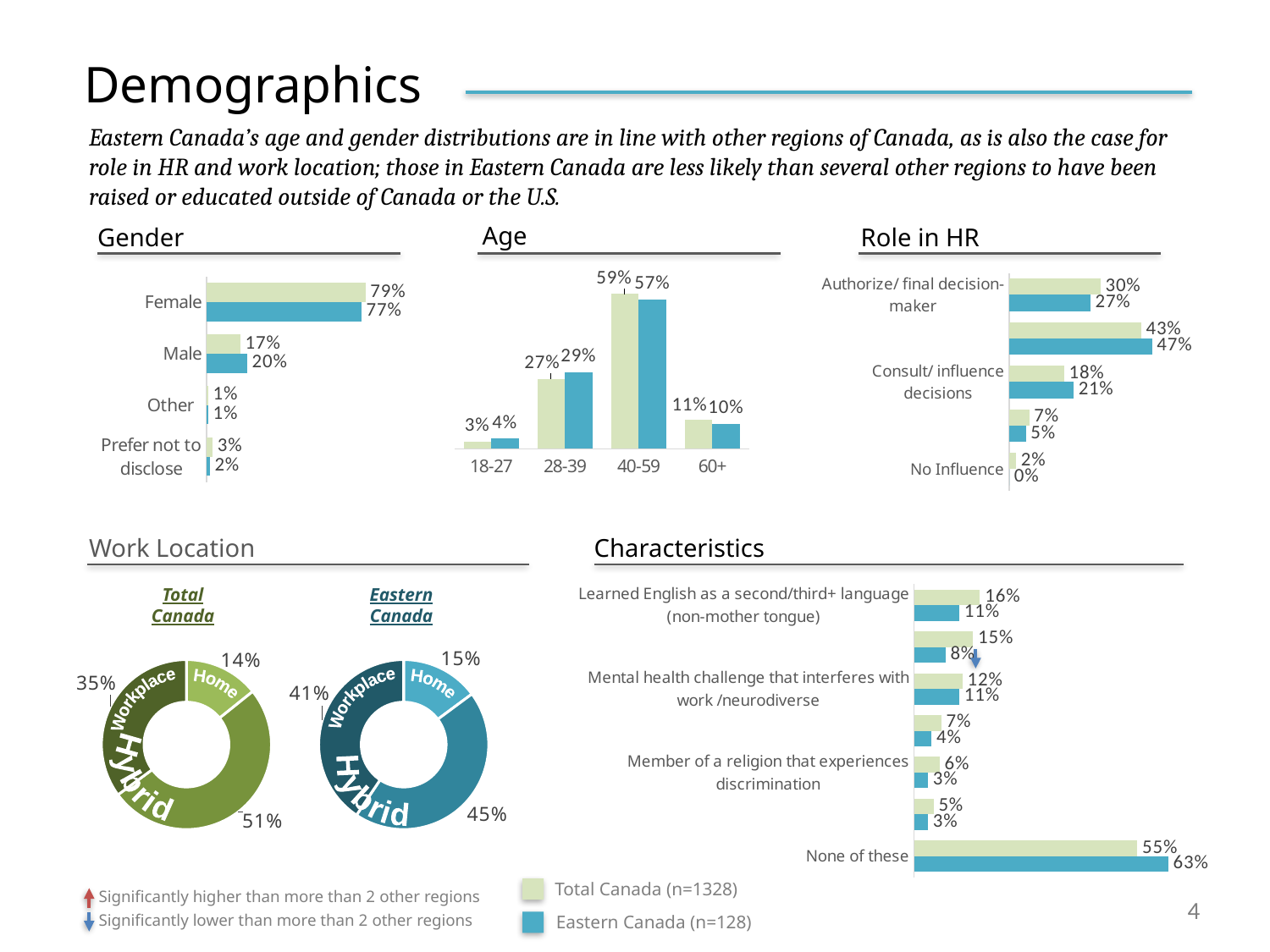
In the Gender chart, what is the Total Canada value for Female? 79% How many series does the legend at the bottom of the slide list? 2 In the Role in HR chart, what is the Eastern Canada value for No Influence? 0% In the Work Location Eastern Canada donut, what is the value for Workplace? 41% In the Age chart, which age group has the highest Eastern Canada value? 40-59 In the Characteristics chart, what is the Eastern Canada value for None of these? 63% In the Work Location Total Canada donut, what share is Hybrid? 51% In the Gender chart, what is the Eastern Canada value for Male? 20% In the Age chart, what is the Total Canada value for 18-27? 3% What kind of chart is the Age chart? bar chart In the Role in HR chart, what is the difference between the Eastern Canada and Total Canada values for Consult/ influence decisions? 3 percentage points In the Age chart, how many age groups are shown on the x axis? 4